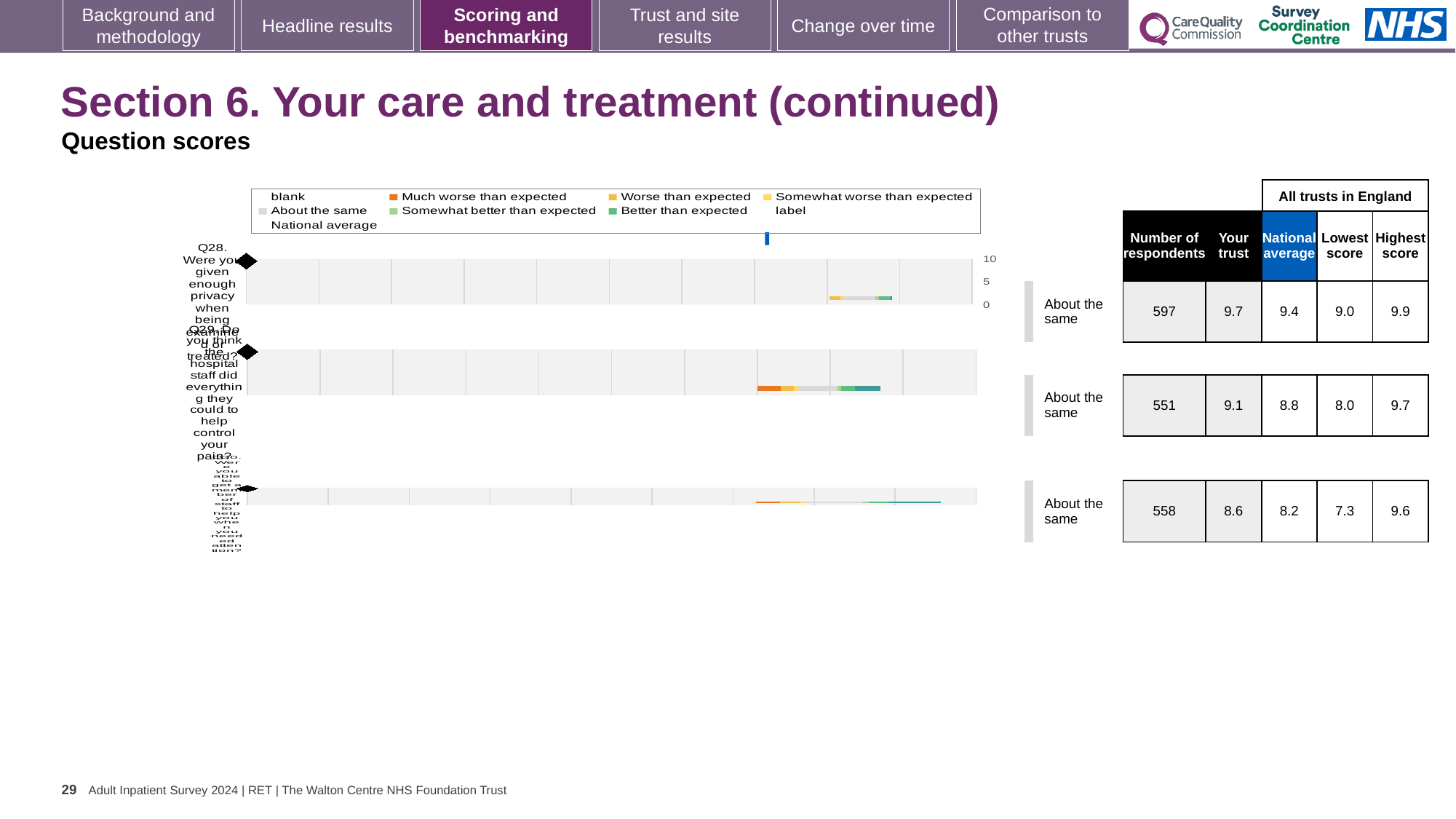
For Q29 (hospital staff helping control your pain), what is the national average score? 8.8 Which question has the lowest 'Your trust' score on this slide? Q30 For Q28 (privacy when being examined or treated), what is the 'Your trust' score? 9.7 Which question has the highest 'Your trust' score on this slide? Q28 For Q28, how much higher is the 'Your trust' score than the national average? 0.3 What kind of chart is used to show the question scores on this slide? Bar chart For the bottom chart (Q30), how many respondents are listed? 558 What benchmark category is shown next to the Q28 chart? About the same For the bottom chart (Q30), what is the difference between the highest score and the lowest score among all trusts in England? 2.3 For Q29, what is the highest score among all trusts in England? 9.7 How many questions (rows) are plotted in the question score charts on this slide? 3 For Q29, which is larger: the 'Your trust' score or the national average? Your trust